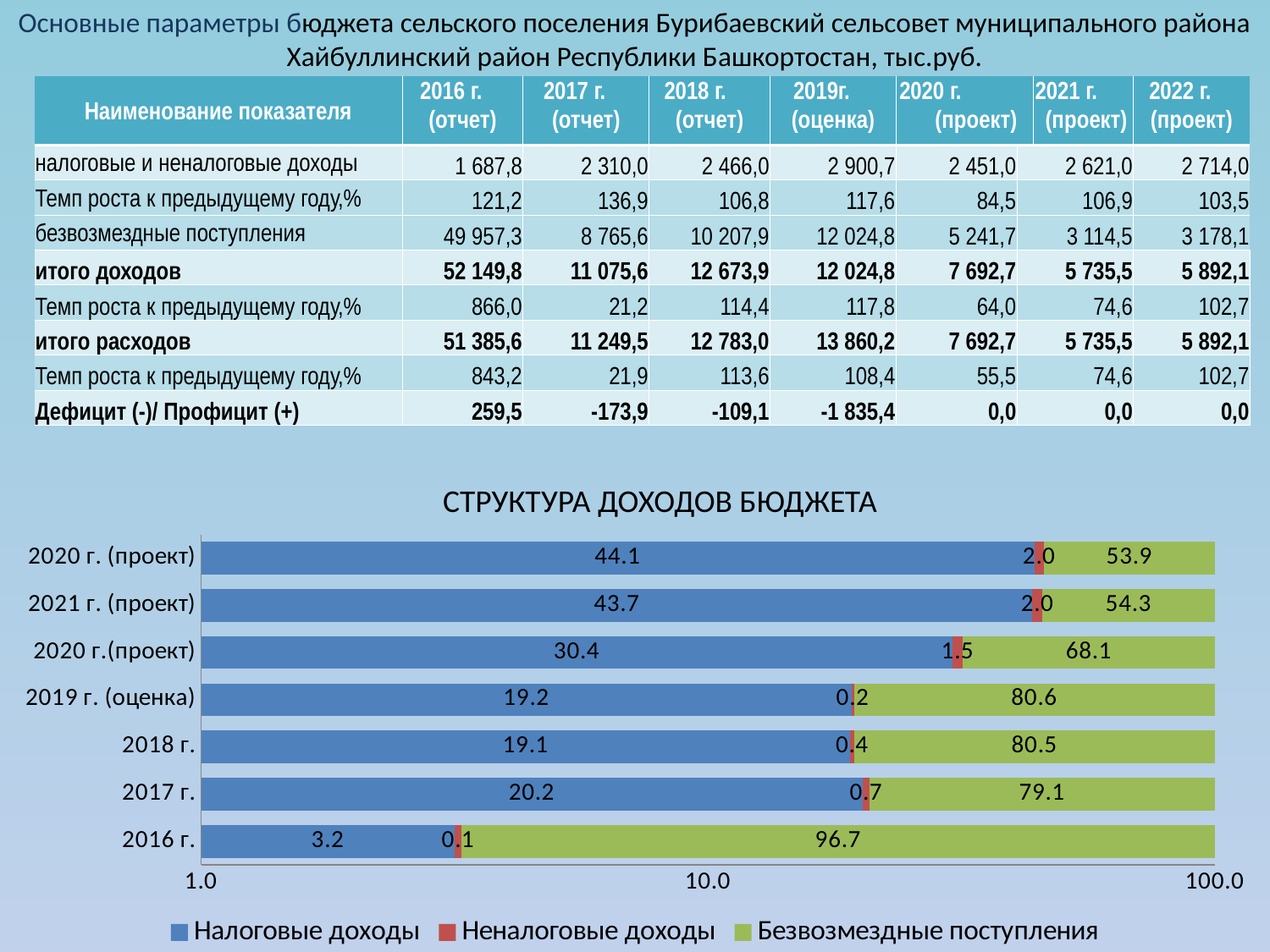
In the chart "СТРУКТУРА ДОХОДОВ БЮДЖЕТА", what is the difference between Безвозмездные поступления for 2016 г. and for 2017 г.? 17.6 What type of chart is shown under the title "СТРУКТУРА ДОХОДОВ БЮДЖЕТА"? Stacked bar chart In the chart "СТРУКТУРА ДОХОДОВ БЮДЖЕТА", how many series does the legend list? 3 In the chart "СТРУКТУРА ДОХОДОВ БЮДЖЕТА", which is larger: Налоговые доходы for 2018 г. or for 2021 г. (проект)? 2021 г. (проект) In the chart "СТРУКТУРА ДОХОДОВ БЮДЖЕТА", which category has the highest value of Безвозмездные поступления? 2016 г. In the chart "СТРУКТУРА ДОХОДОВ БЮДЖЕТА", what is the value of Безвозмездные поступления for 2019 г. (оценка)? 80.6 In the chart "СТРУКТУРА ДОХОДОВ БЮДЖЕТА", what is the total of the stacked bar for 2019 г. (оценка)? 100.0 In the chart "СТРУКТУРА ДОХОДОВ БЮДЖЕТА", what is the value of Налоговые доходы for 2016 г.? 3.2 In the chart "СТРУКТУРА ДОХОДОВ БЮДЖЕТА", what is the value of Неналоговые доходы for 2017 г.? 0.7 In the chart "СТРУКТУРА ДОХОДОВ БЮДЖЕТА", which category has the lowest value of Налоговые доходы? 2016 г. In the chart "СТРУКТУРА ДОХОДОВ БЮДЖЕТА", how many bars (categories) are plotted? 7 In the chart "СТРУКТУРА ДОХОДОВ БЮДЖЕТА", what is the value of Налоговые доходы for 2021 г. (проект)? 43.7